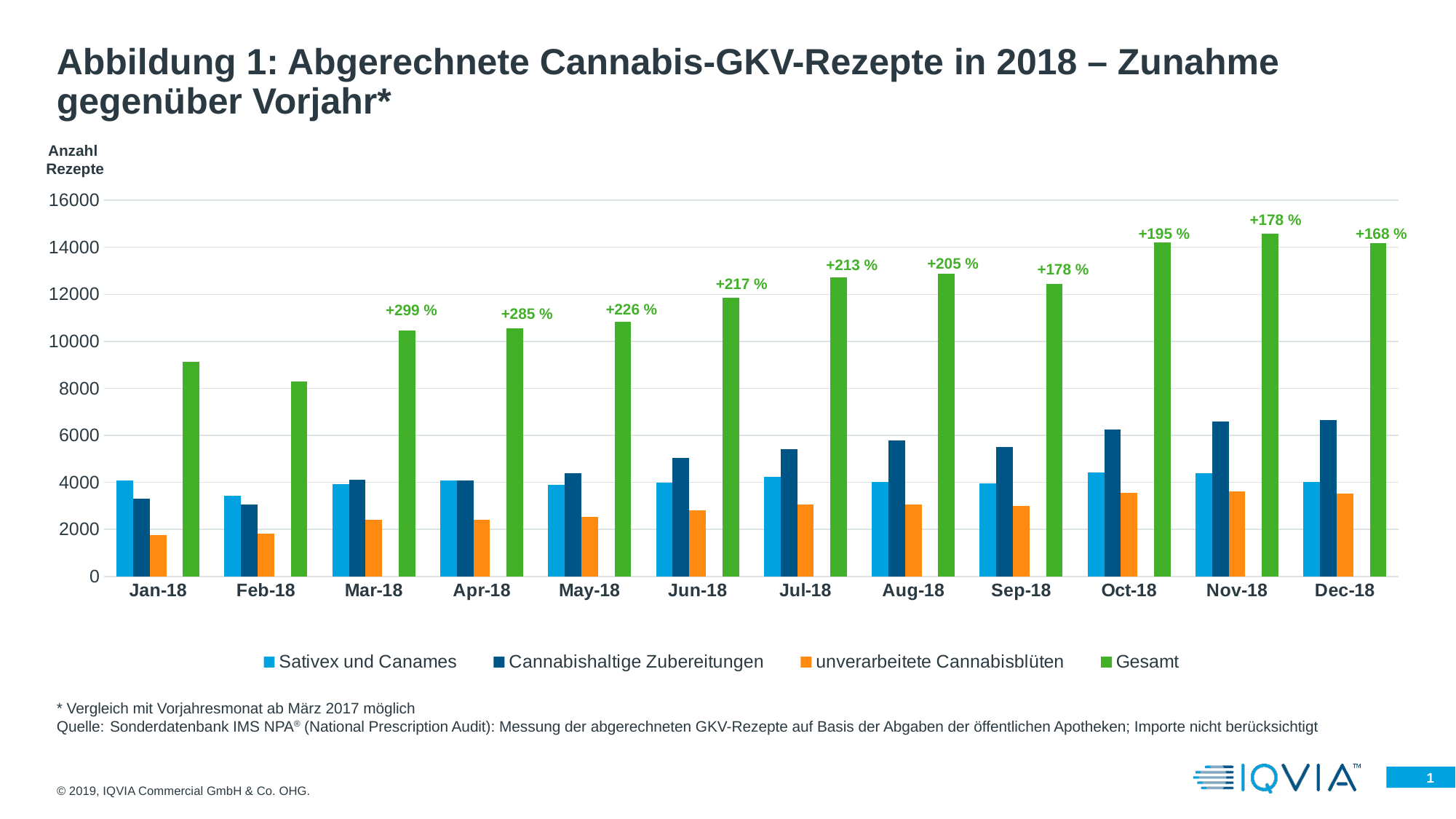
Is the Gesamt value for Jan-18 greater or less than 8000? greater What growth percentage is printed above the Gesamt bar for Dec-18? +168 % Is the value for Cannabishaltige Zubereitungen in Dec-18 greater or less than 6000? greater What kind of chart is shown on the slide? bar chart Which month has the lowest Gesamt bar? Feb-18 What colour represents the Gesamt series in the legend? green Do the values for Cannabishaltige Zubereitungen generally rise or fall from Jan-18 to Dec-18? rise In Jan-18, which is larger: Sativex und Canames or Cannabishaltige Zubereitungen? Sativex und Canames How many months are shown on the x axis? 12 How many series does the legend list? 4 Which month has the highest printed growth percentage above its Gesamt bar? Mar-18 What growth percentage is printed above the Gesamt bar for Mar-18? +299 %